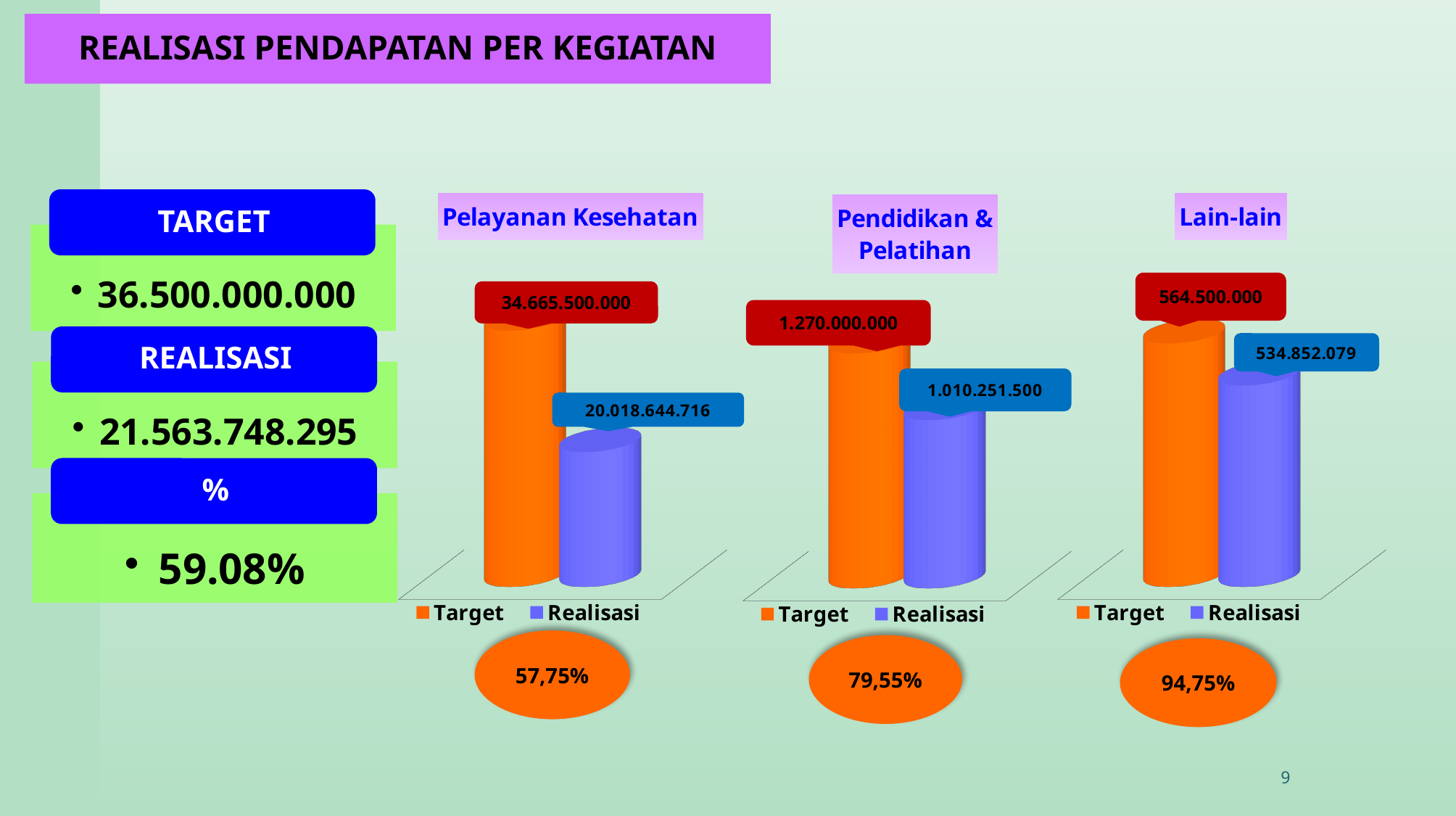
In the Pelayanan Kesehatan chart, which bar is taller, Target or Realisasi? Target In the Pendidikan & Pelatihan chart, what is the value of the Target bar? 1.270.000.000 In the Pendidikan & Pelatihan chart, what is the difference between the Target and Realisasi values? 259.748.500 In the Lain-lain chart, what is the value of the Target bar? 564.500.000 In the Pendidikan & Pelatihan chart, what is the value of the Realisasi bar? 1.010.251.500 How many series does the legend of the Lain-lain chart list? 2 In the Pelayanan Kesehatan chart, what is the value of the Realisasi bar? 20.018.644.716 What type of chart is the Pendidikan & Pelatihan chart? Bar chart In the Lain-lain chart, what is the difference between the Target and Realisasi values? 29.647.921 In the Lain-lain chart, what is the value of the Realisasi bar? 534.852.079 In the Pelayanan Kesehatan chart, what colour is the Target bar? Orange In the Pelayanan Kesehatan chart, what is the value of the Target bar? 34.665.500.000